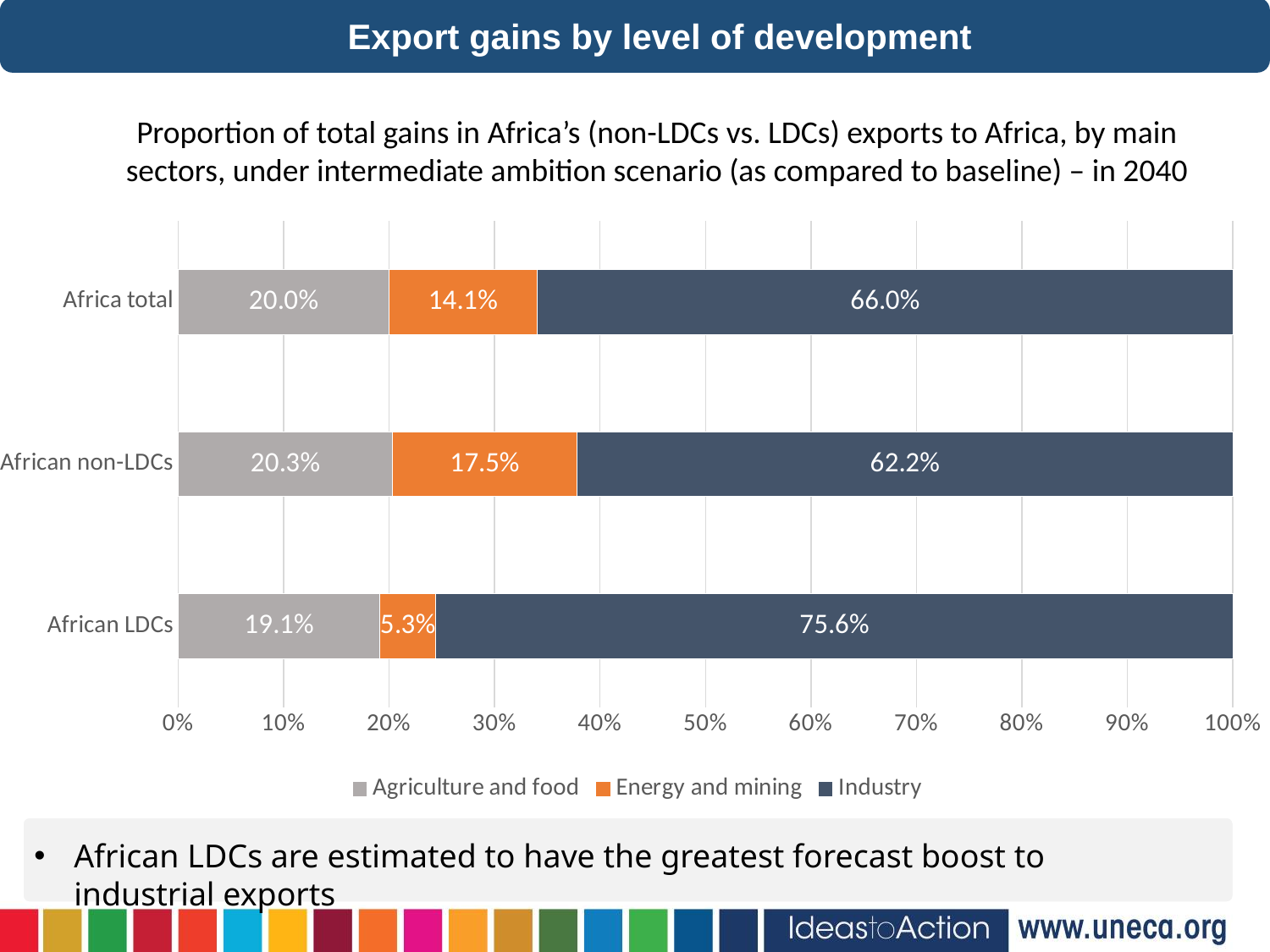
What is the Agriculture and food share for Africa total? 20.0% What kind of chart is shown? Stacked bar chart What is the difference between the Industry shares of African LDCs and African non-LDCs? 13.4% What is the total of the three segments for the African non-LDCs bar? 100.0% How many categories are shown on the y axis? 3 Which is larger: the Energy and mining share for Africa total or for African non-LDCs? African non-LDCs Which series is shown in orange? Energy and mining Which category has the highest Industry share? African LDCs What is the Energy and mining share for African non-LDCs? 17.5% How many series does the legend list? 3 What is the Industry share for African LDCs? 75.6% Which category has the lowest Energy and mining share? African LDCs